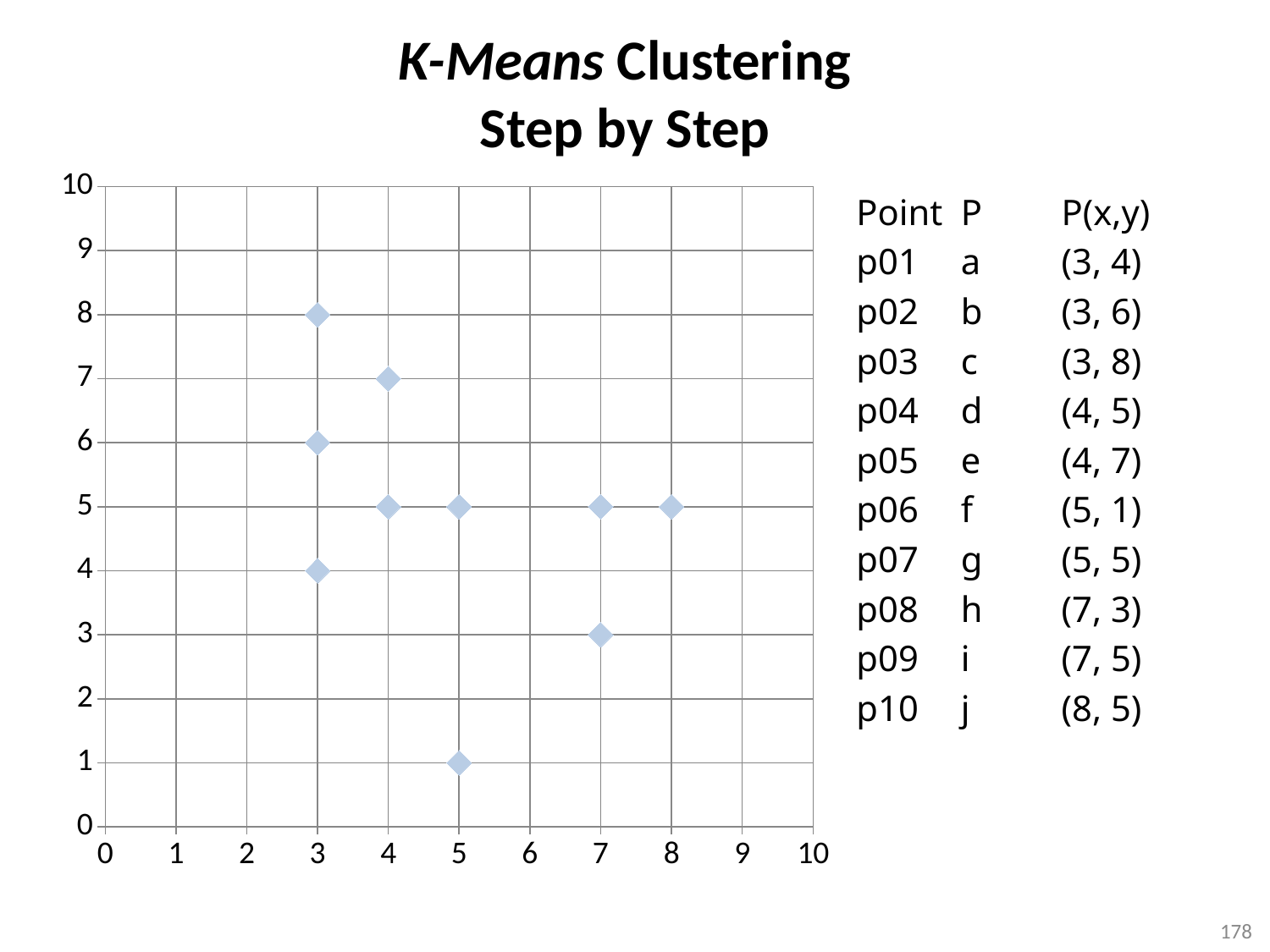
What is the smallest x value among the plotted points? 3 What is the y value of the point plotted at x = 8? 5 What is the largest x value among the plotted points? 8 What is the lowest y value among the plotted points? 1 What is the highest y value among the plotted points? 8 What is the difference between the highest and lowest y values of the plotted points? 7 What are the coordinates of point f (p06)? (5, 1) What is the maximum value shown on the y axis? 10 What kind of chart is shown on the slide? scatter chart How many plotted points have an x value of 3? 3 How many data points are plotted on the chart? 10 How many plotted points have a y value of 5? 4